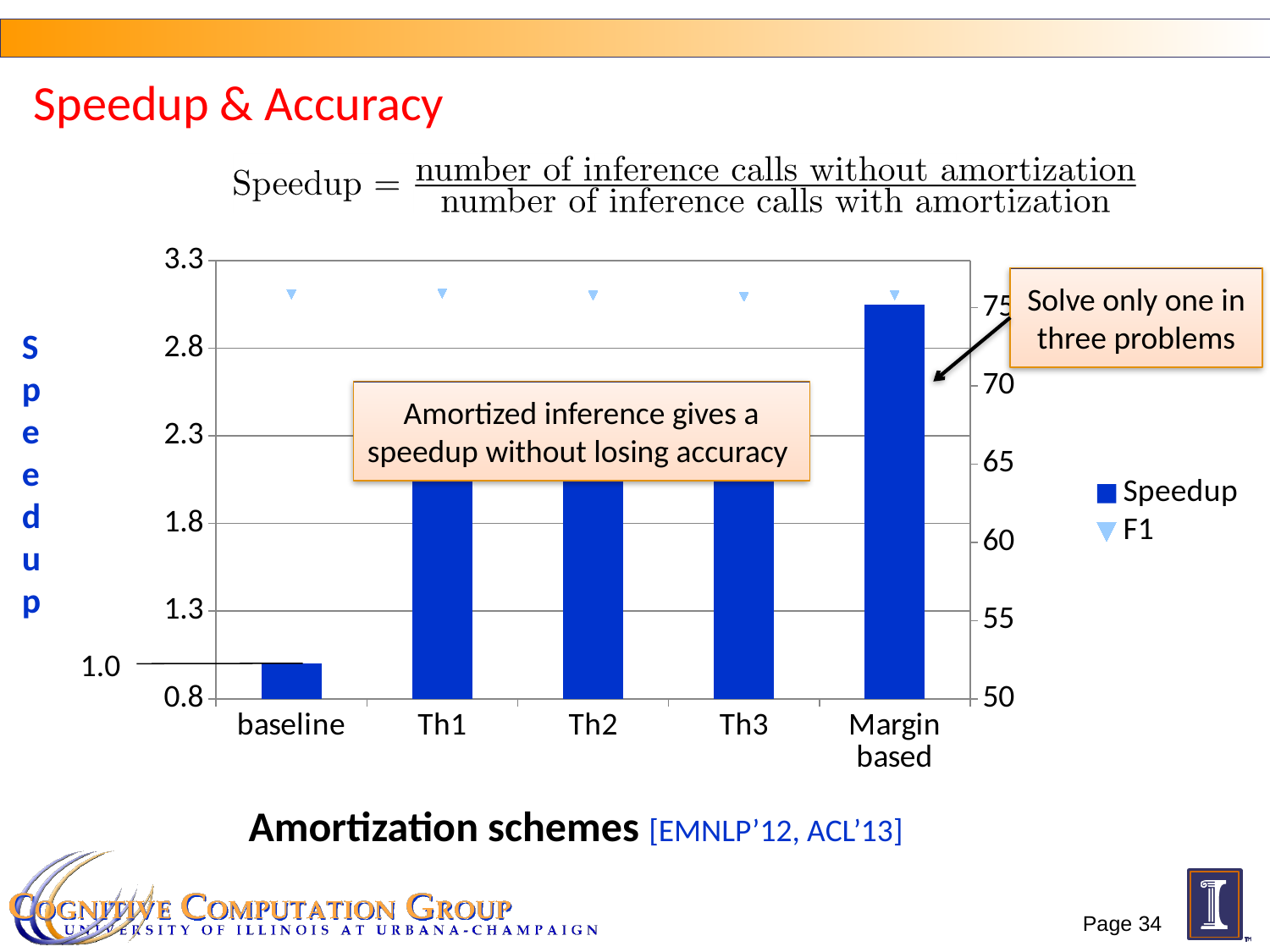
Which amortization scheme has the highest Speedup? Margin based What are the two series listed in the legend? Speedup and F1 Is the Speedup for Margin based greater or less than 2.8? greater How many series does the legend list? 2 How many amortization schemes (categories) are shown on the x axis? 5 Which has the larger Speedup, Th2 or Margin based? Margin based Which amortization scheme has the lowest Speedup? baseline What kind of chart is shown on the slide? bar chart Is the F1 value for baseline greater or less than 70? greater What is the title of the slide containing the chart? Speedup & Accuracy What is the Speedup value for baseline? 1.0 Is the Speedup for Th1 greater or less than 1.8? greater